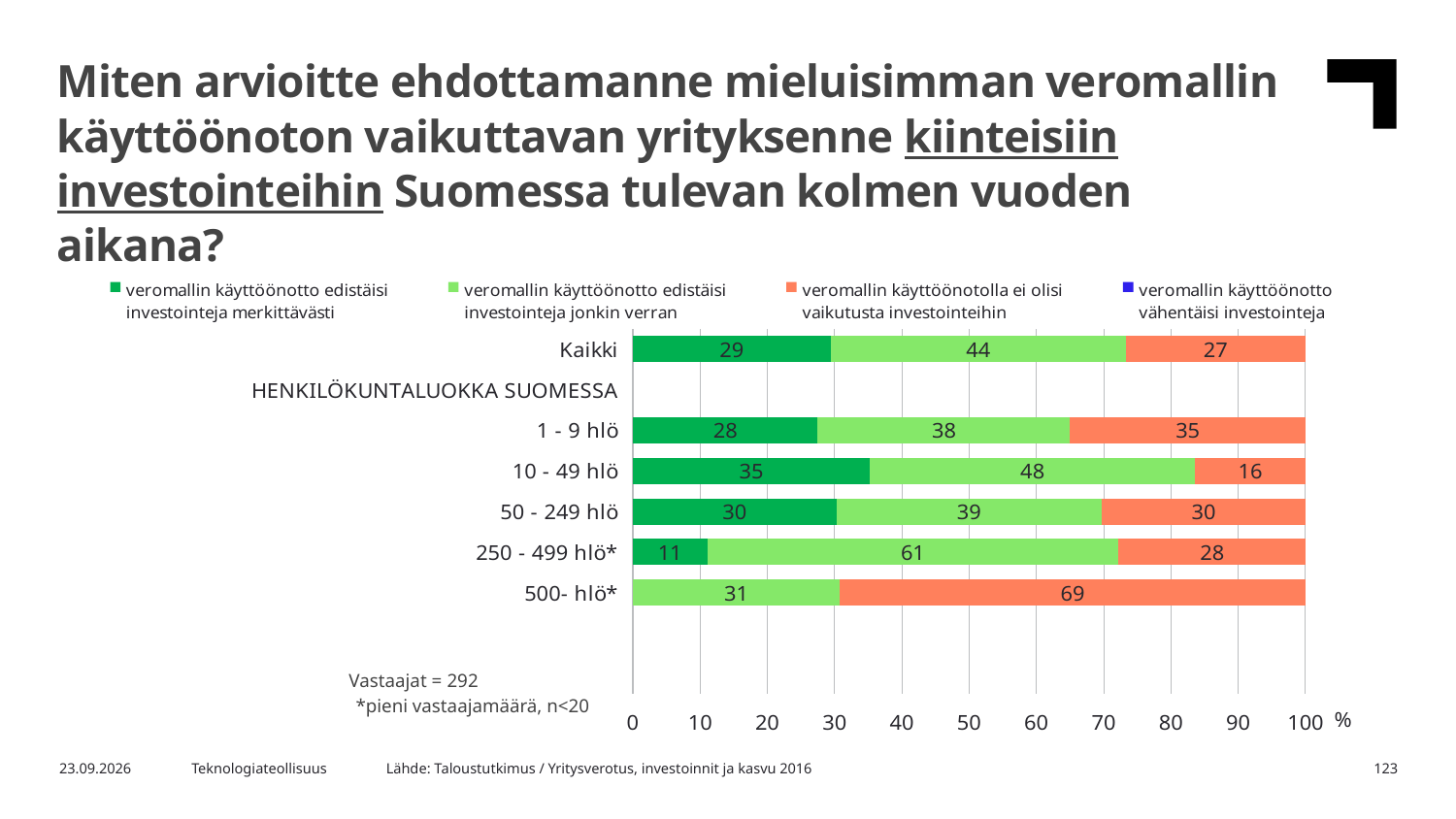
Which is larger for 50 - 249 hlö: 'veromallin käyttöönotto edistäisi investointeja jonkin verran' or 'veromallin käyttöönotolla ei olisi vaikutusta investointeihin'? veromallin käyttöönotto edistäisi investointeja jonkin verran Which category has the highest value for 'veromallin käyttöönotto edistäisi investointeja merkittävästi'? 10 - 49 hlö What is the value of 'veromallin käyttöönotto edistäisi investointeja jonkin verran' for 250 - 499 hlö*? 61 How many series does the legend list? 4 How many categories (bars) are plotted in the chart? 6 What is the difference between the 'veromallin käyttöönotto edistäisi investointeja jonkin verran' values for 10 - 49 hlö and 1 - 9 hlö? 10 What is the value of 'veromallin käyttöönotolla ei olisi vaikutusta investointeihin' for 500- hlö*? 69 What is the total of the stacked bar for 1 - 9 hlö? 101 What is the number of respondents (Vastaajat) stated on the slide? 292 Which category has the lowest value for 'veromallin käyttöönotolla ei olisi vaikutusta investointeihin'? 10 - 49 hlö What type of chart is shown on the slide? stacked bar chart What is the value of 'veromallin käyttöönotto edistäisi investointeja merkittävästi' for Kaikki? 29